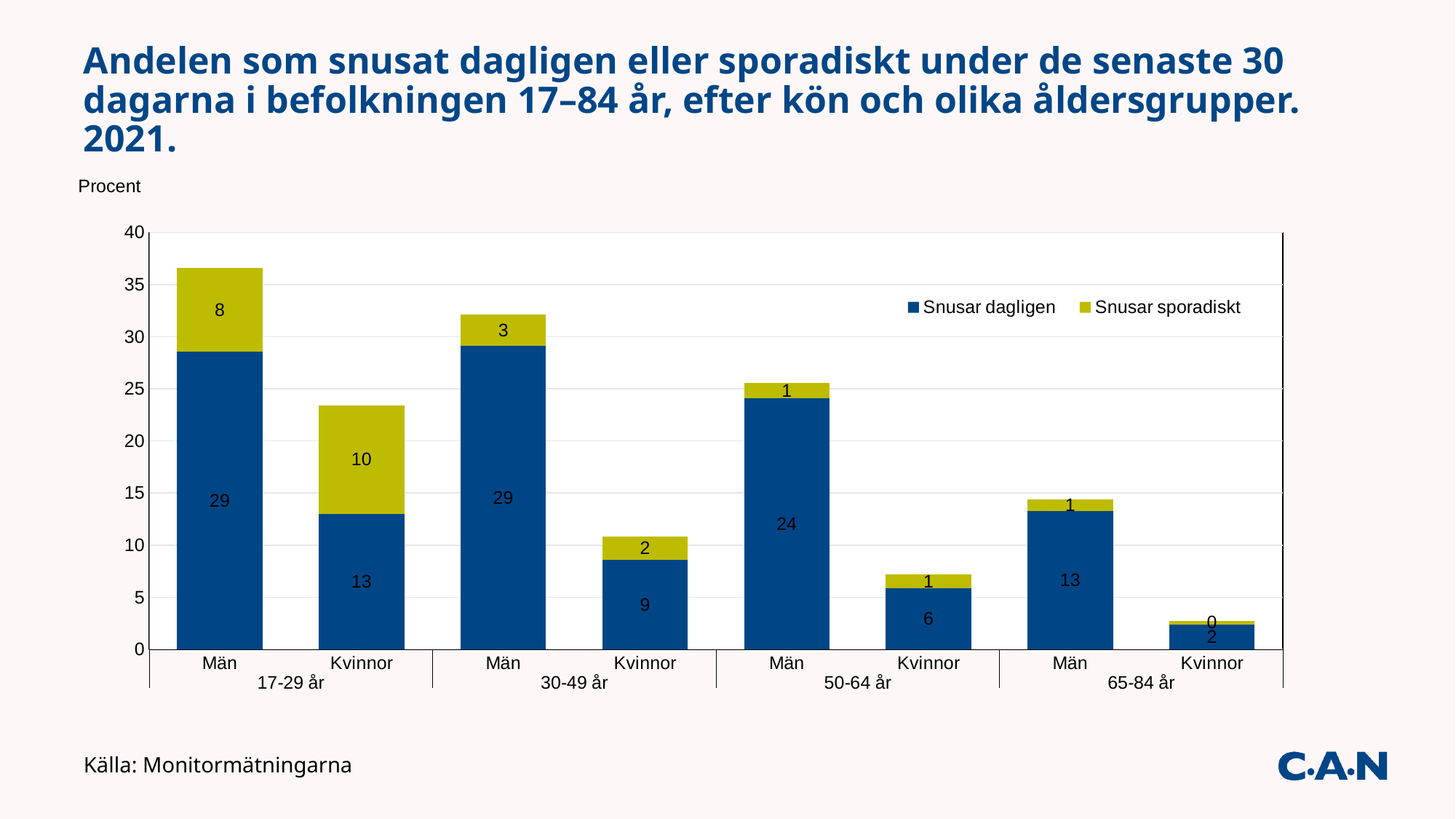
What is the total of the stacked bar for Män aged 30-49 år? 32 What is the value of 'Snusar sporadiskt' for Kvinnor aged 17-29 år? 10 What is the difference in 'Snusar dagligen' between Män aged 50-64 år and Kvinnor aged 50-64 år? 18 What is the value of 'Snusar dagligen' for Män aged 17-29 år? 29 What is the value of 'Snusar sporadiskt' for Kvinnor aged 65-84 år? 0 Which group has the lowest value for 'Snusar dagligen'? Kvinnor 65-84 år What is the value of 'Snusar dagligen' for Kvinnor aged 50-64 år? 6 How many bars are plotted in the chart? 8 Which is larger: 'Snusar dagligen' for Män aged 65-84 år or for Kvinnor aged 30-49 år? Män 65-84 år How many series does the legend list? 2 What kind of chart is shown on the slide? Stacked bar chart Which group has the highest value for 'Snusar sporadiskt'? Kvinnor 17-29 år